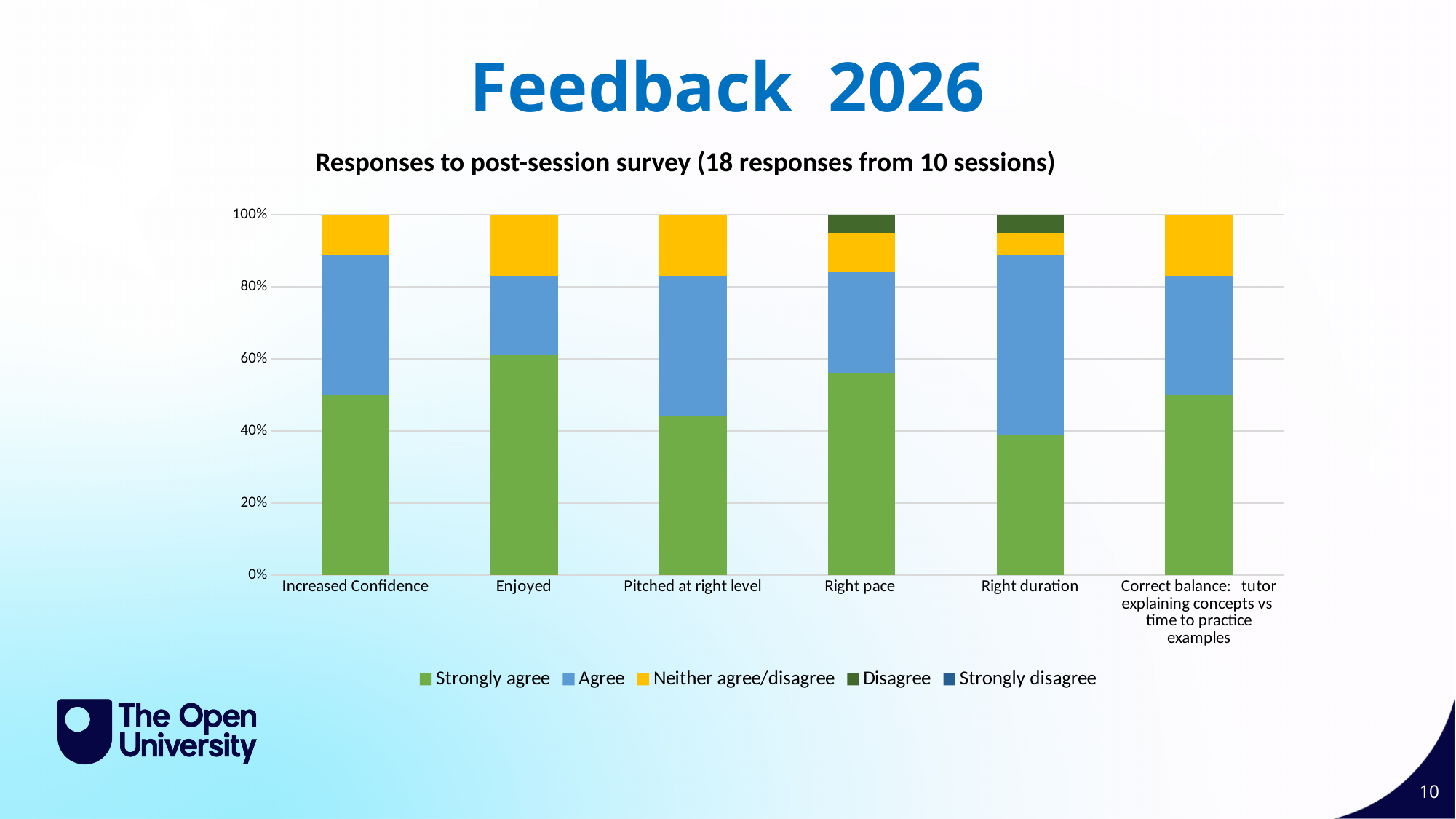
What is the title of the chart? Responses to post-session survey (18 responses from 10 sessions) Which categories include a Disagree segment? Right pace and Right duration Which has the larger Agree segment: Right duration or Enjoyed? Right duration Which category has the smallest Strongly agree share? Right duration How many survey statements (categories) are shown on the x axis? 6 Is the Strongly agree share for Right duration greater or less than 60%? less Which category has the largest Strongly agree share? Enjoyed Is the Strongly agree share for Pitched at right level greater or less than 60%? less What kind of chart is shown on the slide? Stacked bar chart What is the total height of the stacked bar for Increased Confidence? 100% How many series does the legend list? 5 Is the Strongly agree share for Enjoyed greater or less than 40%? greater